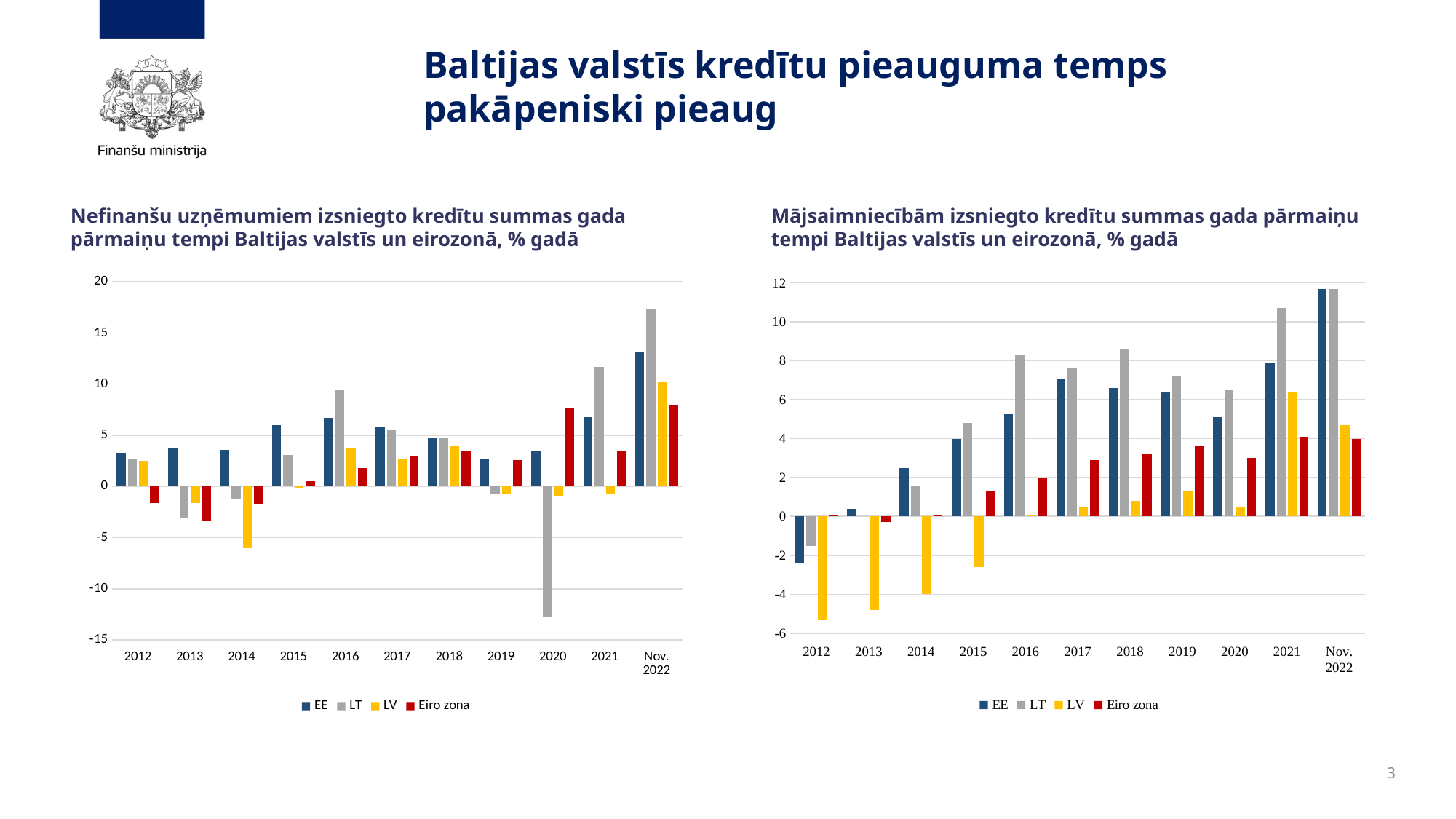
In the left chart, 'Nefinanšu uzņēmumiem izsniegto kredītu summas gada pārmaiņu tempi', which is larger in 2016: EE or LT? LT In the right chart, 'Mājsaimniecībām izsniegto kredītu summas gada pārmaiņu tempi', which series has the lowest value in 2012? LV How many series does the legend of the right chart, 'Mājsaimniecībām izsniegto kredītu summas gada pārmaiņu tempi', list? 4 In the right chart, 'Mājsaimniecībām izsniegto kredītu summas gada pārmaiņu tempi', is the value for LV in 2012 greater or less than -4? less In the left chart, 'Nefinanšu uzņēmumiem izsniegto kredītu summas gada pārmaiņu tempi', is the value for LT in 2020 greater or less than -10? less How many time periods are shown on the x axis of the left chart, 'Nefinanšu uzņēmumiem izsniegto kredītu summas gada pārmaiņu tempi'? 11 In the right chart, 'Mājsaimniecībām izsniegto kredītu summas gada pārmaiņu tempi', which colour represents the Eiro zona series? Red What kind of chart is the left chart, 'Nefinanšu uzņēmumiem izsniegto kredītu summas gada pārmaiņu tempi'? Bar chart In the right chart, 'Mājsaimniecībām izsniegto kredītu summas gada pārmaiņu tempi', is the value for LT in 2021 greater or less than 10? greater In the left chart, 'Nefinanšu uzņēmumiem izsniegto kredītu summas gada pārmaiņu tempi', which series has the lowest value in 2020? LT In the left chart, 'Nefinanšu uzņēmumiem izsniegto kredītu summas gada pārmaiņu tempi', which series has the highest value in Nov. 2022? LT